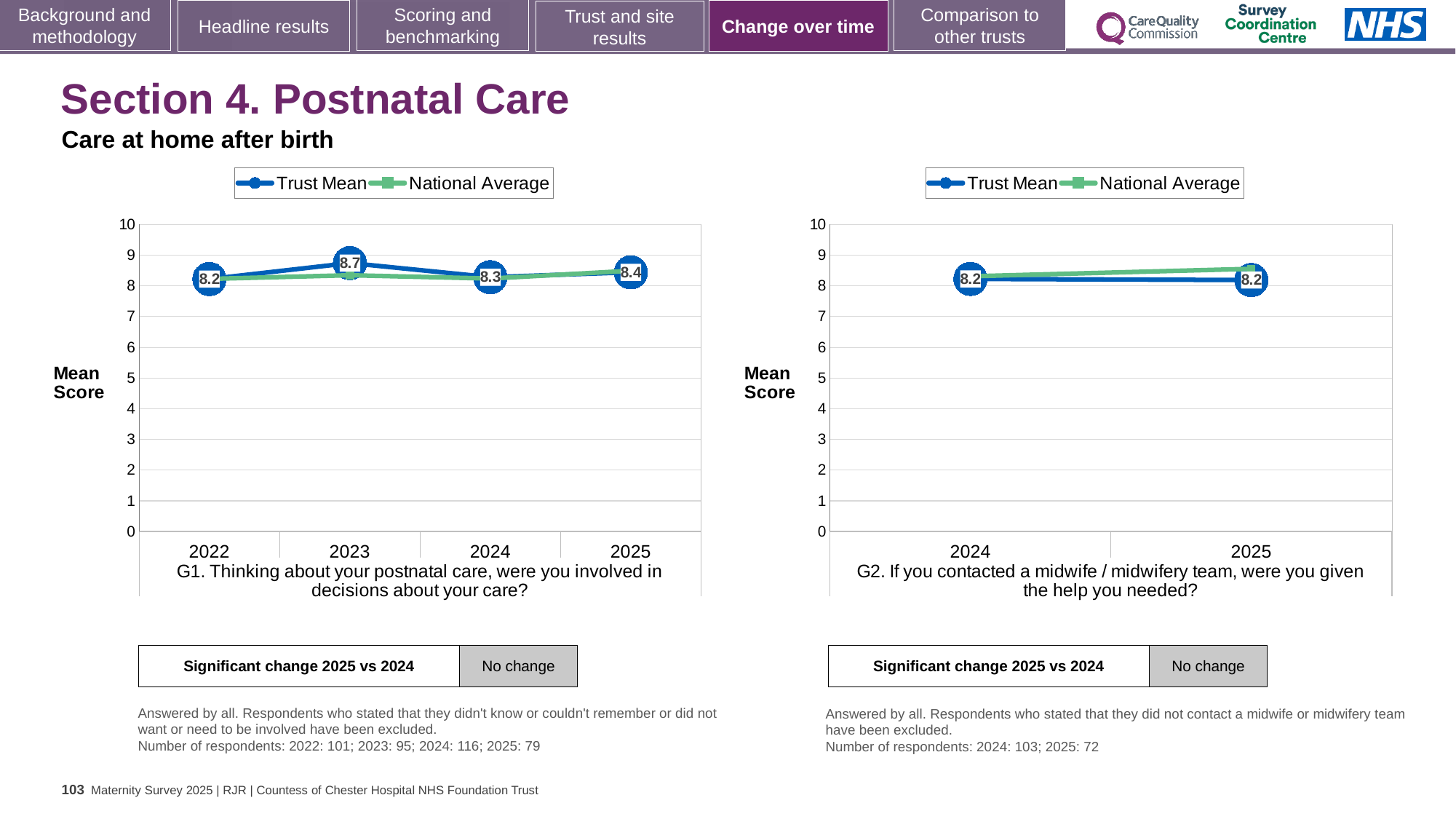
In the G1 chart (left), what is the Trust Mean for 2025? 8.4 In the G2 chart (right), what does the box next to 'Significant change 2025 vs 2024' say? No change In the G1 chart (left), how many years are plotted on the x axis? 4 In the G2 chart (right), what is the difference between the Trust Mean in 2025 and in 2024? 0 In the G1 chart (left), which year has the highest Trust Mean? 2023 In the G2 chart (right), what is the Trust Mean for 2024? 8.2 In the G2 chart (right), how many series does the legend list? 2 In the G1 chart (left), what is the Trust Mean for 2023? 8.7 In the G1 chart (left), what is the difference between the Trust Mean in 2023 and in 2024? 0.4 In the G1 chart (left), is the National Average for 2025 greater or less than 7? greater In the G1 chart (left), is the Trust Mean for 2022 larger or smaller than the Trust Mean for 2023? smaller What kind of chart is the G2 chart (right)? line chart